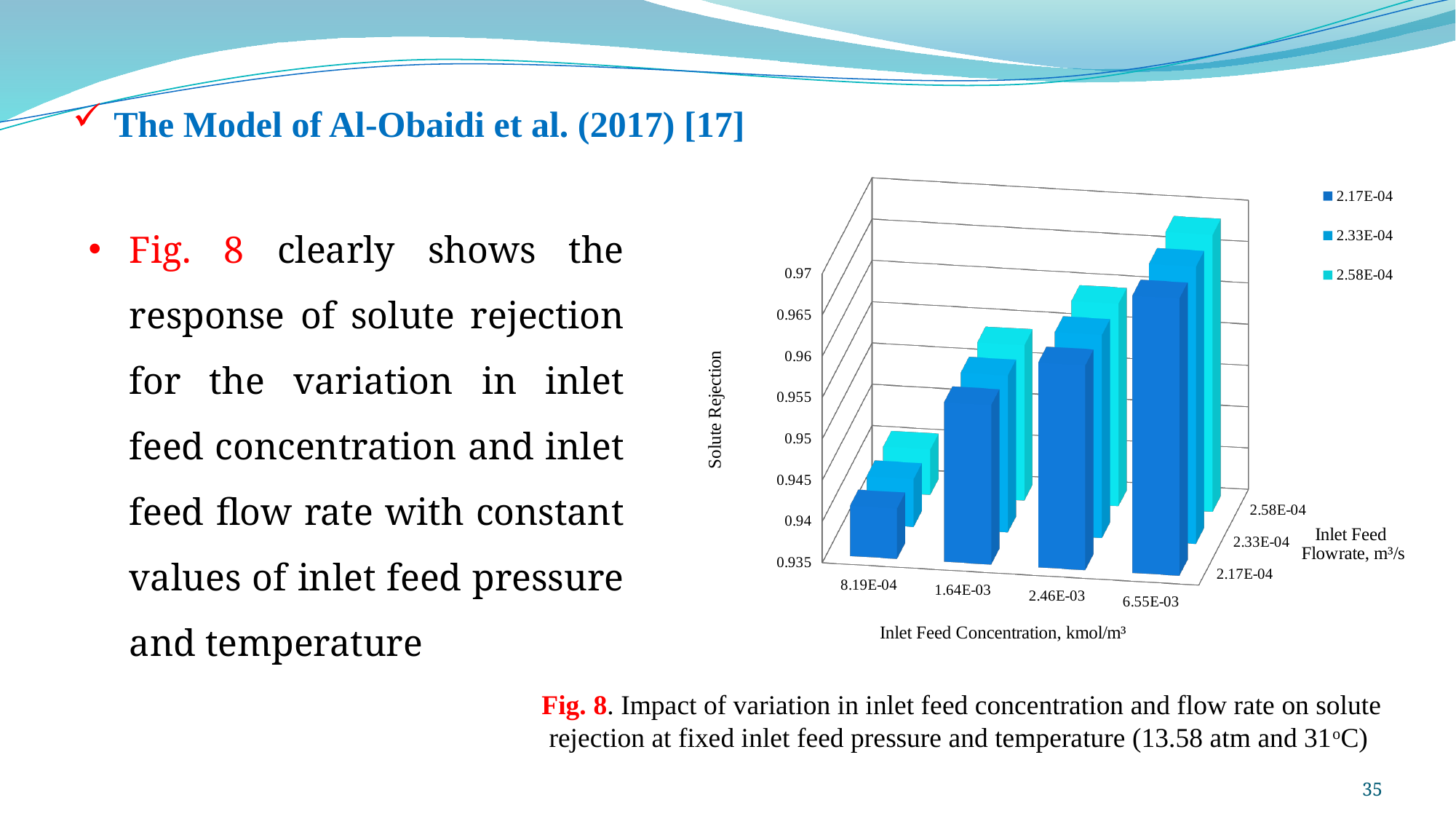
For the 2.17E-04 series, is the solute rejection at 8.19E-04 greater or less than 0.945? less For the 2.17E-04 series, which has the larger solute rejection: 1.64E-03 or 2.46E-03? 2.46E-03 Which inlet feed concentration has the lowest solute rejection for the 2.17E-04 series? 8.19E-04 What kind of chart is shown on the slide? bar chart What is the title of the vertical axis of the chart? Solute Rejection How many series does the chart legend list? 3 What is the title of the horizontal axis of the chart? Inlet Feed Concentration, kmol/m³ Which inlet feed concentration has the highest solute rejection for the 2.17E-04 series? 6.55E-03 How many inlet feed concentration categories are shown on the x axis of the chart? 4 Does solute rejection rise or fall as inlet feed concentration increases along the x axis? rise For the 2.17E-04 series, which has the larger solute rejection: 8.19E-04 or 6.55E-03? 6.55E-03 For the 2.17E-04 series, is the solute rejection at 6.55E-03 greater or less than 0.96? greater